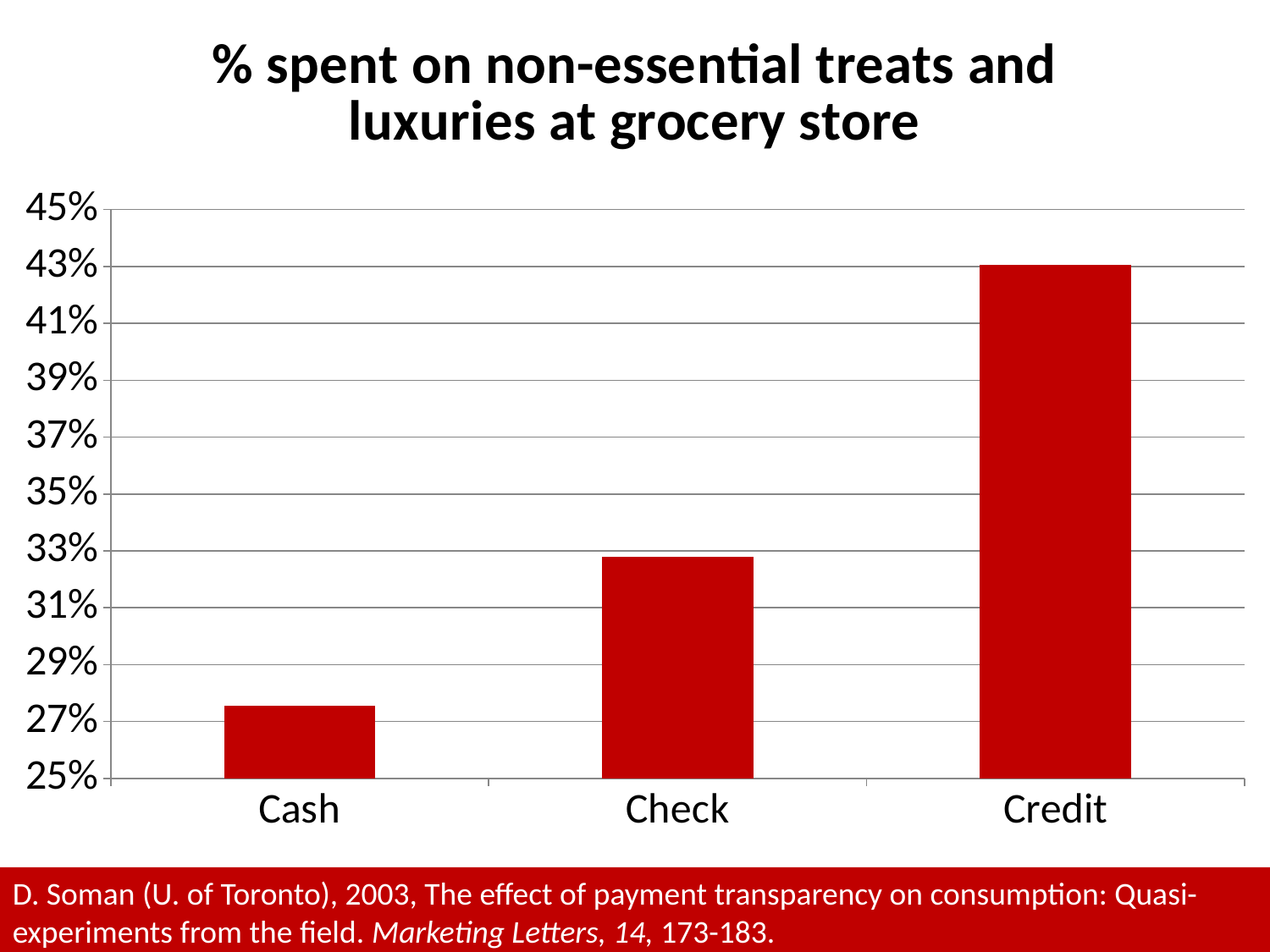
Is the value for Check greater or less than 33%? less Is the value for Cash greater or less than 29%? less Is the value for Check greater or less than 31%? greater Which payment method has the lowest % spent on non-essential treats and luxuries? Cash What is the title of the chart? % spent on non-essential treats and luxuries at grocery store What type of chart is shown on the slide? bar chart Which payment method has the highest % spent on non-essential treats and luxuries? Credit How many categories are shown on the x axis of the chart? 3 Which is larger, the value for Check or the value for Cash? Check Do the values rise or fall moving from Cash to Credit along the x axis? rise Which is larger, the value for Credit or the value for Check? Credit